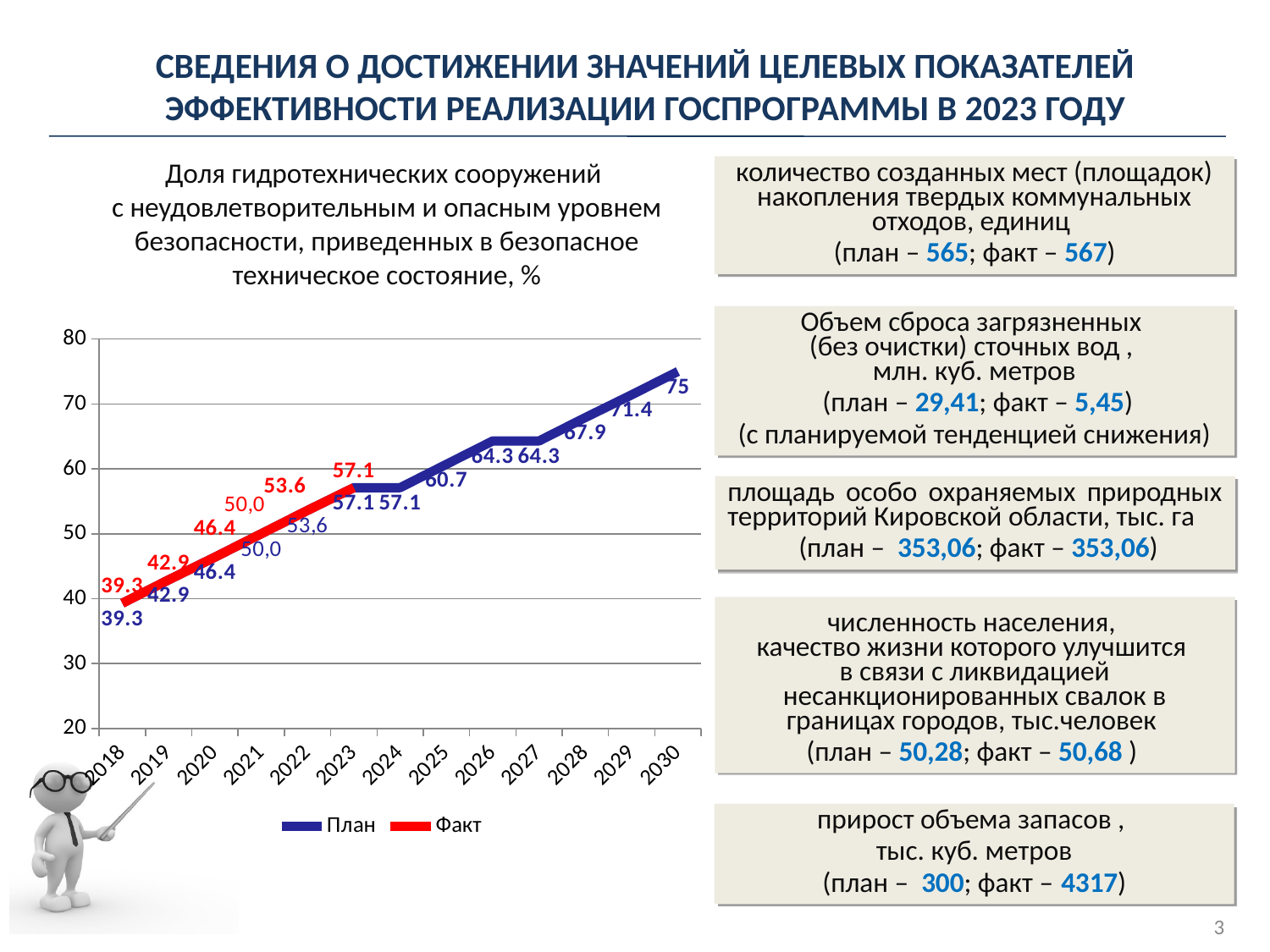
What is the План value for 2025? 60.7 In which year is the План value highest? 2030 How many series does the chart legend list? 2 Do the План values rise or fall from 2018 to 2030? rise What is the Факт value for 2019? 42.9 Which series is drawn in red in the chart? Факт How many years are shown on the x axis of the chart? 13 In which year is the План value lowest? 2018 What is the Факт value for 2023? 57.1 What kind of chart is shown on the slide? line chart What is the difference between the План value for 2030 and the План value for 2018? 35.7 What is the План value for 2030? 75